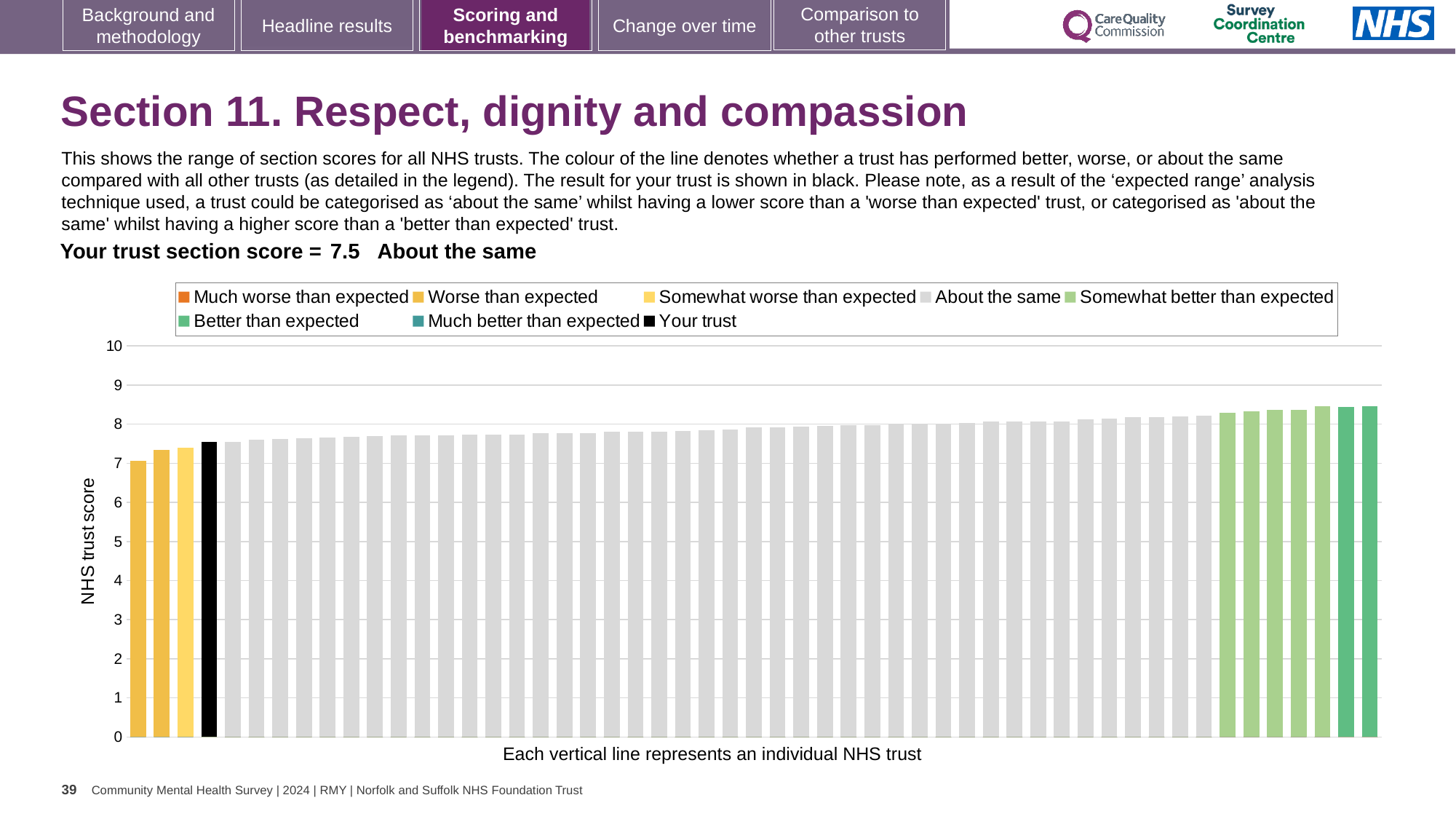
Is the value of the leftmost bar greater or less than 8? less Is the value of the rightmost bar greater or less than 8? greater Do the bar values rise or fall from left to right along the x axis? rise What is the label on the vertical axis of the chart? NHS trust score What is the section score for your trust shown on the slide? 7.5 How many bars are coloured as 'Better than expected' (dark green)? 2 Which legend category does the lowest-scoring trust belong to? Worse than expected What kind of chart is shown on the slide? bar chart How many entries does the chart legend list? 8 Is the value of the black bar for your trust greater or less than 7? greater Which category is your trust placed in for this section? About the same